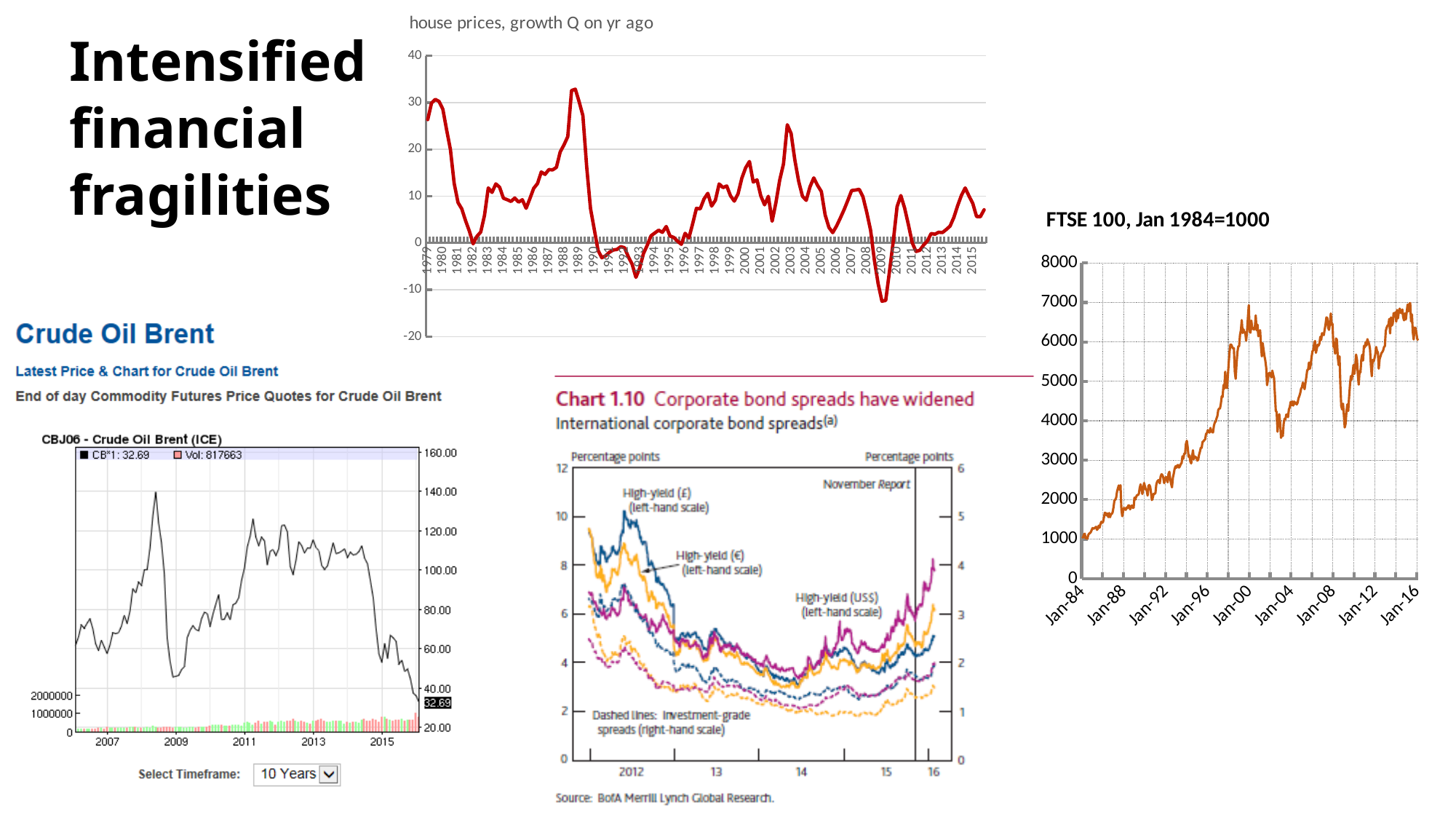
On the Chart 1.10 corporate bond spreads chart, is the High-yield (£) spread at its 2012 peak greater or less than 8 percentage points? greater On the Crude Oil Brent chart, what is the latest price shown (CB*1)? 32.69 On the FTSE 100 chart, does the index generally rise or fall from Jan-84 to Jan-16? rise On the FTSE 100 chart, is the value around Jan-04 greater or less than 5000? less On the 'house prices, growth Q on yr ago' chart, is the value at the 1989 peak greater or less than 20? greater What is the source given for Chart 1.10 on corporate bond spreads? BofA Merrill Lynch Global Research On the 'house prices, growth Q on yr ago' chart, in which year does the line reach its lowest point? 2009 What is the title of the chart on the right of the slide? FTSE 100, Jan 1984=1000 What kind of chart is the 'house prices, growth Q on yr ago' chart? line chart